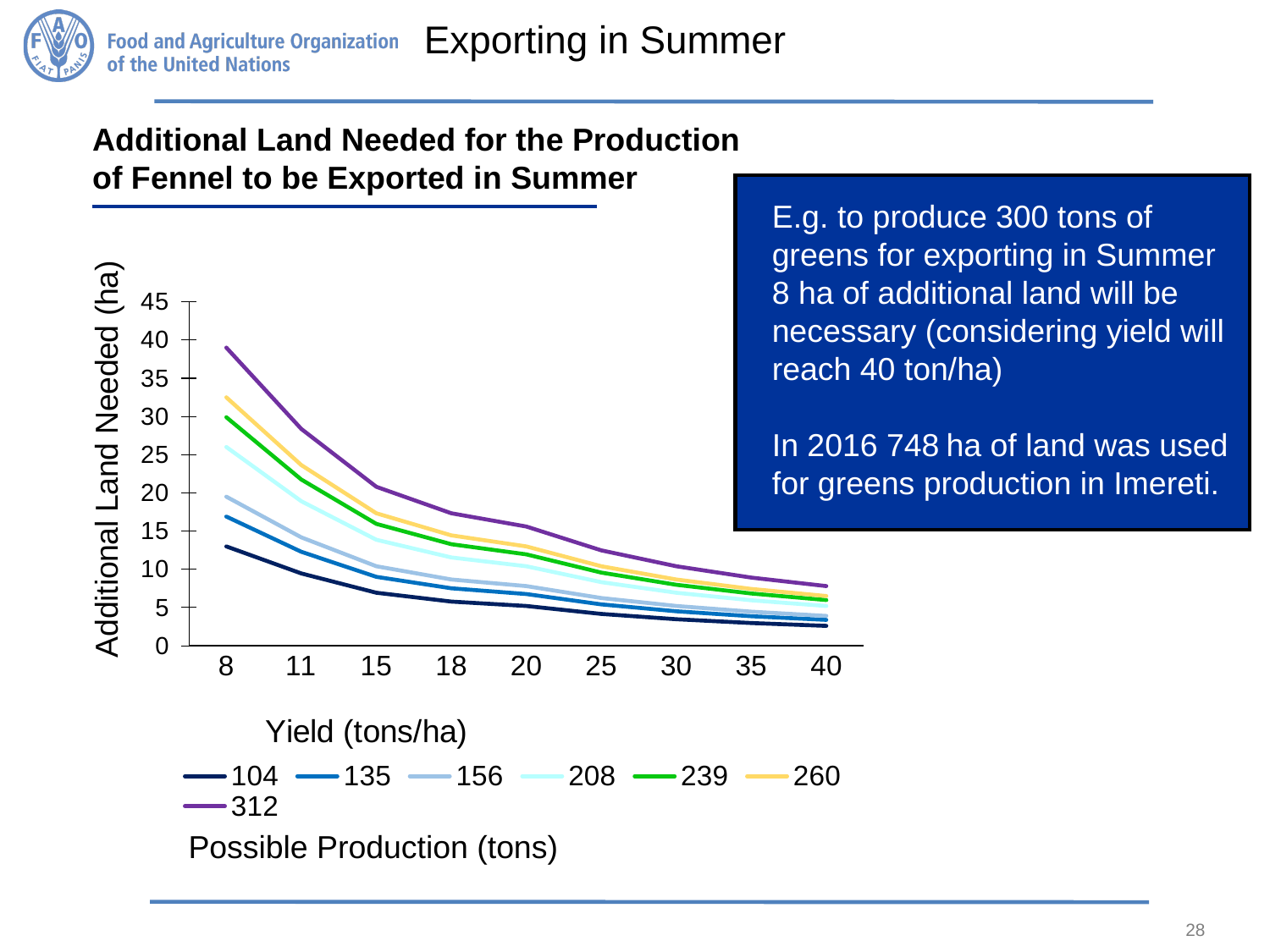
How many series does the legend list? 7 Do the values of the 312 series rise or fall as yield increases along the x axis? fall Is the value for the 312 series at a yield of 40 tons/ha greater or less than 10? less Is the value for the 239 series at a yield of 8 tons/ha greater or less than 25? greater Is the value for the 312 series at a yield of 8 tons/ha greater or less than 35? greater How many yield values are shown along the x axis? 9 What is the label of the y axis of the chart? Additional Land Needed (ha) Which series has the lowest additional land needed at a yield of 8 tons/ha? 104 At a yield of 15 tons/ha, which series needs more additional land, 312 or 104? 312 Which series has the highest additional land needed at a yield of 8 tons/ha? 312 What kind of chart is shown on the slide? line chart